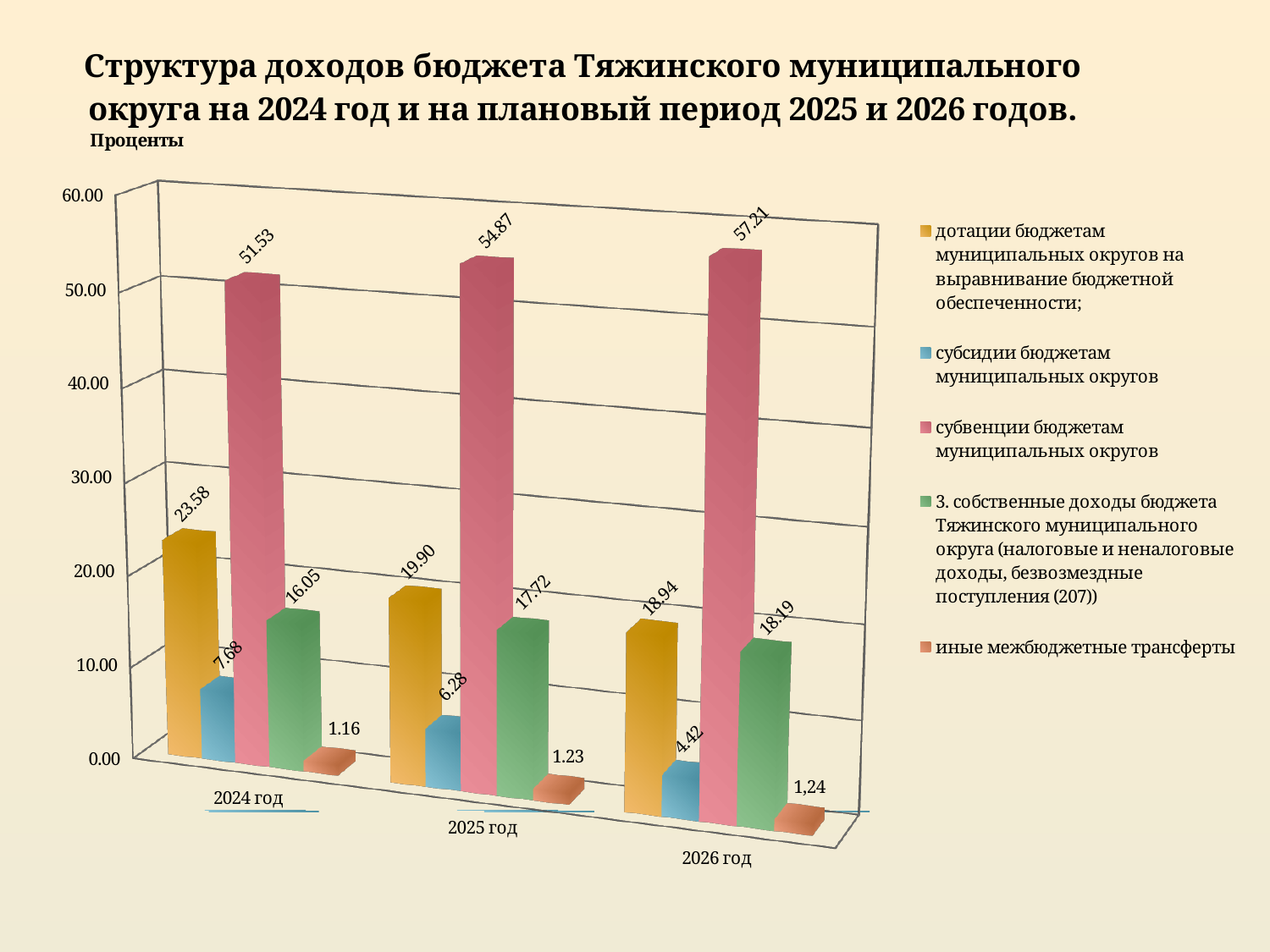
How many years (categories) are shown on the x axis? 3 What kind of chart is shown on the slide? bar chart Do the values for субвенции бюджетам муниципальных округов rise or fall from 2024 год to 2026 год? rise What is the value for субсидии бюджетам муниципальных округов in 2025 год? 6.28 What is the value for субвенции бюджетам муниципальных округов in 2024 год? 51.53 How many series does the legend list? 5 What is the value for иные межбюджетные трансферты in 2024 год? 1.16 What is the value for дотации бюджетам муниципальных округов на выравнивание бюджетной обеспеченности in 2026 год? 18.94 What is the difference between the values for дотации бюджетам муниципальных округов на выравнивание бюджетной обеспеченности in 2024 год and 2025 год? 3.68 In which year is the value for субвенции бюджетам муниципальных округов the highest? 2026 год In which year is the value for субсидии бюджетам муниципальных округов the lowest? 2026 год Which is larger in 2025 год: собственные доходы бюджета Тяжинского муниципального округа or дотации бюджетам муниципальных округов на выравнивание бюджетной обеспеченности? дотации бюджетам муниципальных округов на выравнивание бюджетной обеспеченности